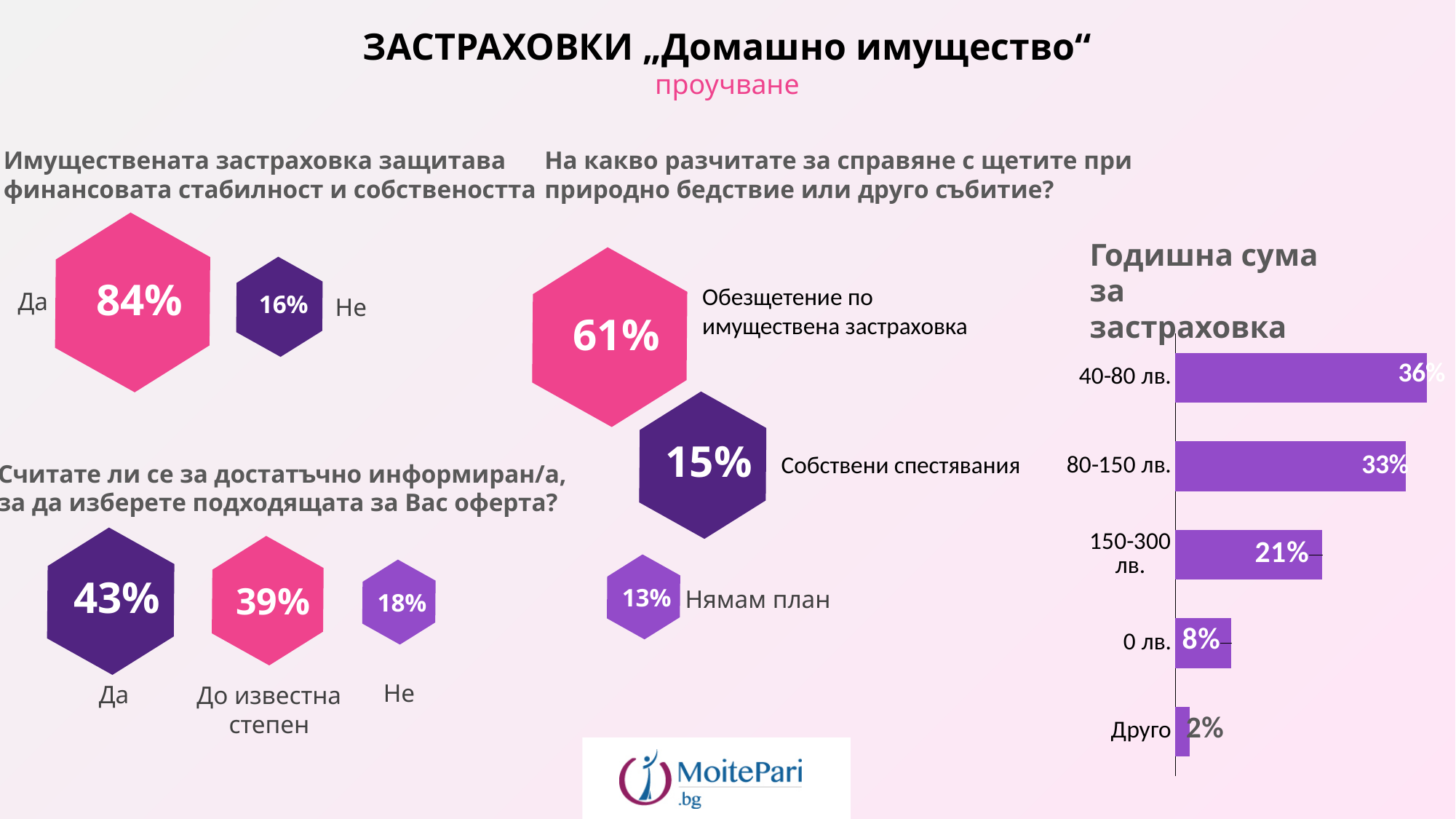
In the chart 'Годишна сума за застраховка', what is the value for '150-300 лв.'? 21% In the chart 'Годишна сума за застраховка', what is the value for 'Друго'? 2% How many categories does the chart 'Годишна сума за застраховка' show? 5 In the chart 'Годишна сума за застраховка', which is larger: the value for '80-150 лв.' or the value for '150-300 лв.'? 80-150 лв. In the chart 'Годишна сума за застраховка', which category has the lowest value? Друго In the chart 'Годишна сума за застраховка', which category has the highest value? 40-80 лв. What is the title of the bar chart on the right side of the slide? Годишна сума за застраховка In the chart 'Годишна сума за застраховка', what is the difference between the values for '40-80 лв.' and '80-150 лв.'? 3% In the chart 'Годишна сума за застраховка', what is the value for '40-80 лв.'? 36% In the chart 'Годишна сума за застраховка', what is the difference between the values for '150-300 лв.' and '0 лв.'? 13% What kind of chart is 'Годишна сума за застраховка'? Bar chart In the chart 'Годишна сума за застраховка', what is the value for '0 лв.'? 8%